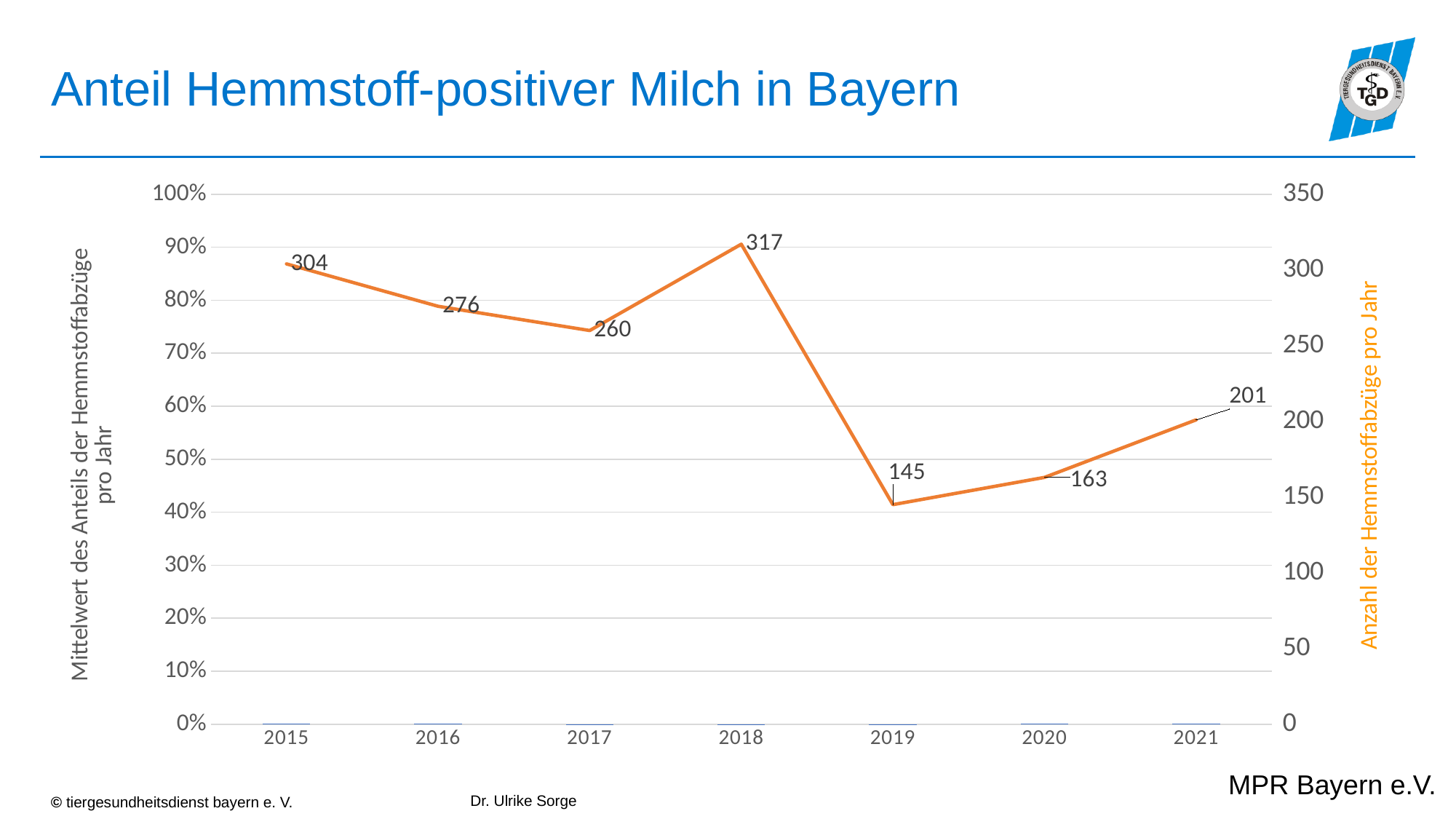
Which year has the highest number of Hemmstoffabzüge on the orange line? 2018 What is the number of Hemmstoffabzüge (orange line) for 2015? 304 Which year has a higher number of Hemmstoffabzüge, 2017 or 2020? 2017 What is the difference between the number of Hemmstoffabzüge in 2015 and in 2016? 28 Which year has the lowest number of Hemmstoffabzüge on the orange line? 2019 How many years are shown on the x axis of the chart? 7 What is the number of Hemmstoffabzüge (orange line) for 2018? 317 What is the number of Hemmstoffabzüge (orange line) for 2019? 145 What is the difference between the number of Hemmstoffabzüge in 2018 and in 2019? 172 Does the orange line rise or fall from 2019 to 2021? rise What is the label of the right-hand (secondary) vertical axis? Anzahl der Hemmstoffabzüge pro Jahr What is the number of Hemmstoffabzüge (orange line) for 2021? 201